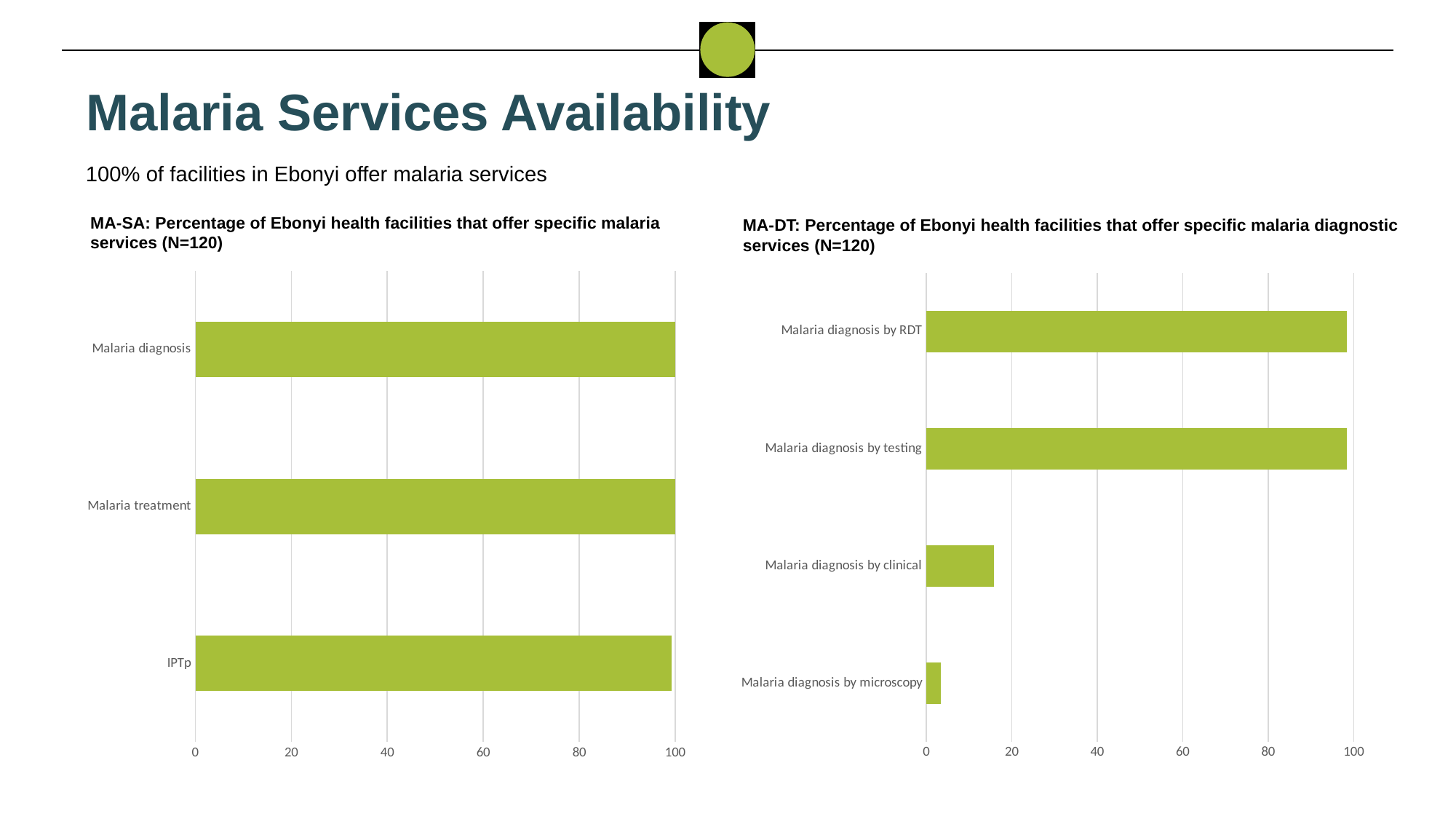
On the MA-SA chart (left), what percentage of facilities offer malaria diagnosis? 100 On the MA-DT chart (right), is the value for malaria diagnosis by clinical greater or less than 20? less On the MA-DT chart (right), which is larger: malaria diagnosis by clinical or malaria diagnosis by microscopy? Malaria diagnosis by clinical What type of chart is the MA-DT chart on the right? Bar chart On the MA-DT chart (right), how many diagnostic service categories are plotted? 4 What is the sample size (N) stated in the title of the MA-SA chart on the left? N=120 On the MA-SA chart (left), is the value for IPTp greater or less than 80? greater On the MA-SA chart (left), what percentage of facilities offer malaria treatment? 100 On the MA-DT chart (right), is the value for malaria diagnosis by RDT greater or less than 80? greater On the MA-DT chart (right), which diagnostic service has the lowest percentage of facilities? Malaria diagnosis by microscopy On the MA-SA chart (left), how many service categories are plotted? 3